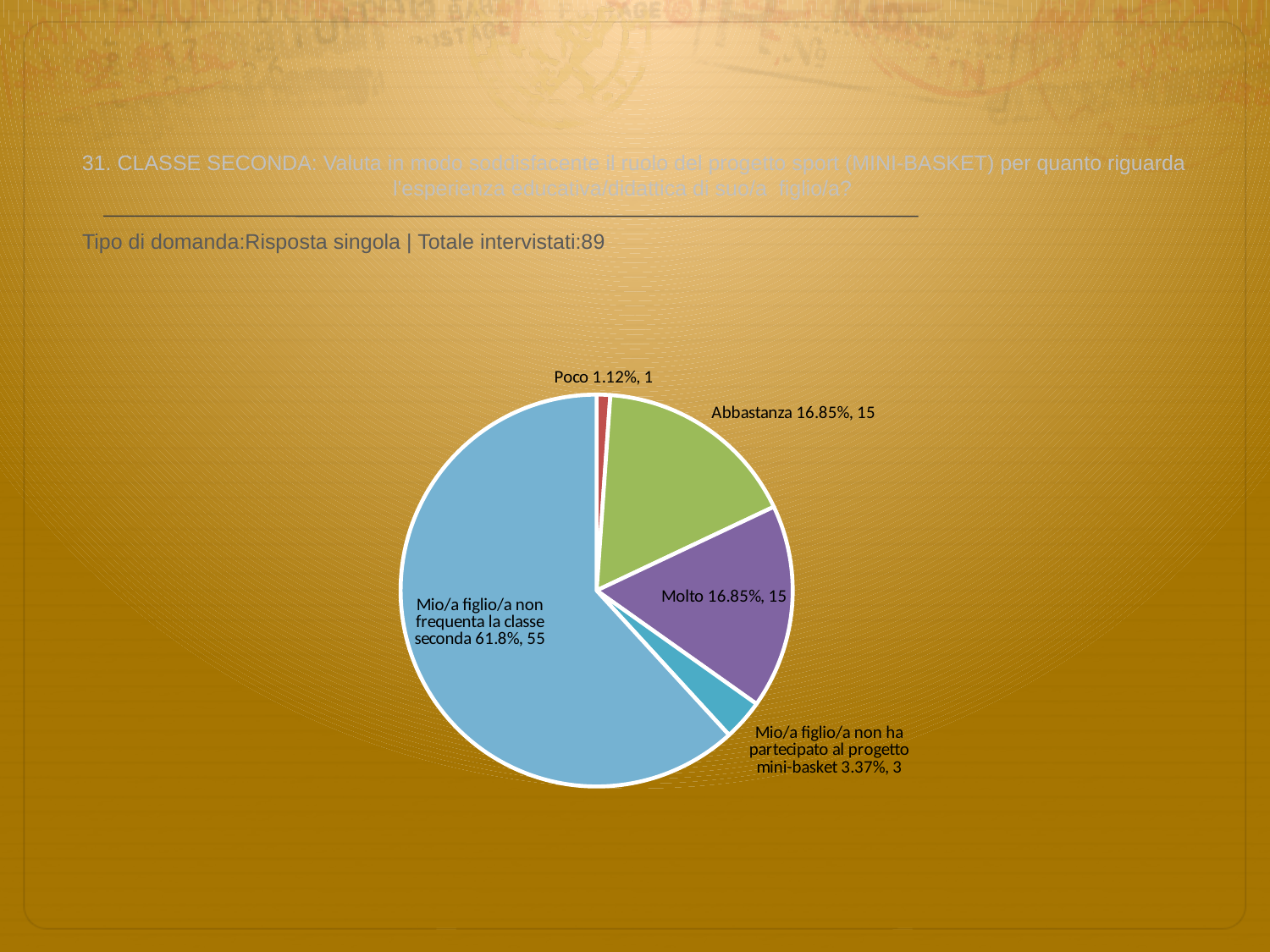
How many respondents answered "Abbastanza"? 15 Which has more respondents, "Poco" or "Mio/a figlio/a non ha partecipato al progetto mini-basket"? Mio/a figlio/a non ha partecipato al progetto mini-basket What percentage is shown for "Poco"? 1.12% How many slices does the pie chart have? 5 What is the difference in number of respondents between "Mio/a figlio/a non frequenta la classe seconda" and "Molto"? 40 What is the total number of respondents (Totale intervistati) stated on the slide? 89 How many respondents chose "Mio/a figlio/a non ha partecipato al progetto mini-basket"? 3 Which category has the smallest slice of the pie? Poco Which category has the largest slice of the pie? Mio/a figlio/a non frequenta la classe seconda What kind of chart is shown on the slide? pie chart What share of the pie does "Mio/a figlio/a non frequenta la classe seconda" represent? 61.8% What percentage of respondents answered "Molto"? 16.85%